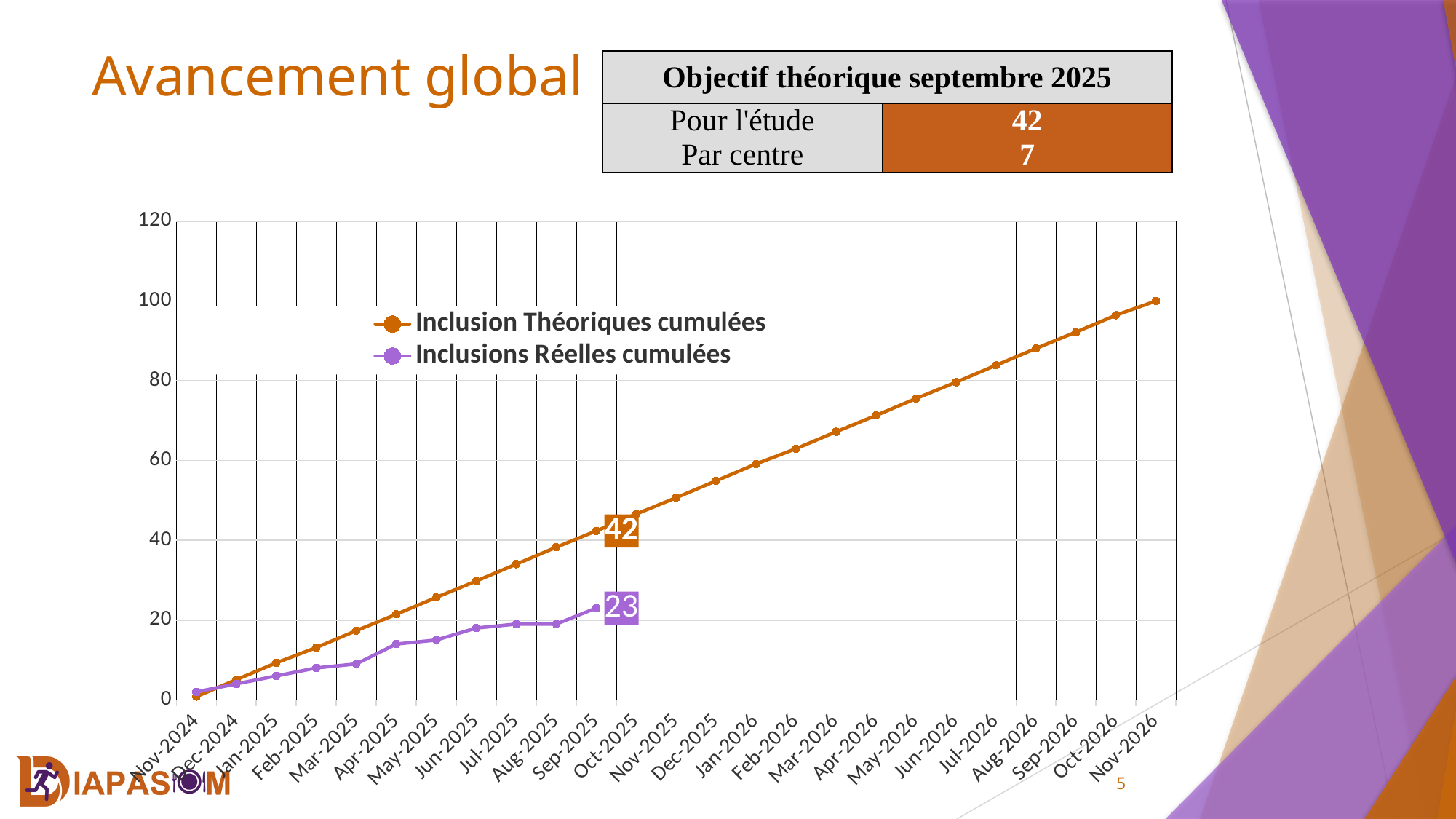
Does the Inclusion Théoriques cumulées series rise or fall from Nov-2024 to Nov-2026? Rise What is the value of Inclusions Réelles cumulées at Sep-2025? 23 What is the difference between Inclusion Théoriques cumulées and Inclusions Réelles cumulées at Sep-2025? 19 How many series does the legend list? 2 What kind of chart is shown on the slide? Line chart Is the value for Inclusion Théoriques cumulées at Jan-2026 greater or less than 40? greater What colour is the Inclusions Réelles cumulées line? Purple Is the value for Inclusions Réelles cumulées at Mar-2025 greater or less than 20? less Is the value for Inclusion Théoriques cumulées at Nov-2026 greater or less than 80? greater At Sep-2025, which series has the larger value, Inclusion Théoriques cumulées or Inclusions Réelles cumulées? Inclusion Théoriques cumulées What is the value of Inclusion Théoriques cumulées at Sep-2025? 42 How many months are shown on the x axis of the chart? 25